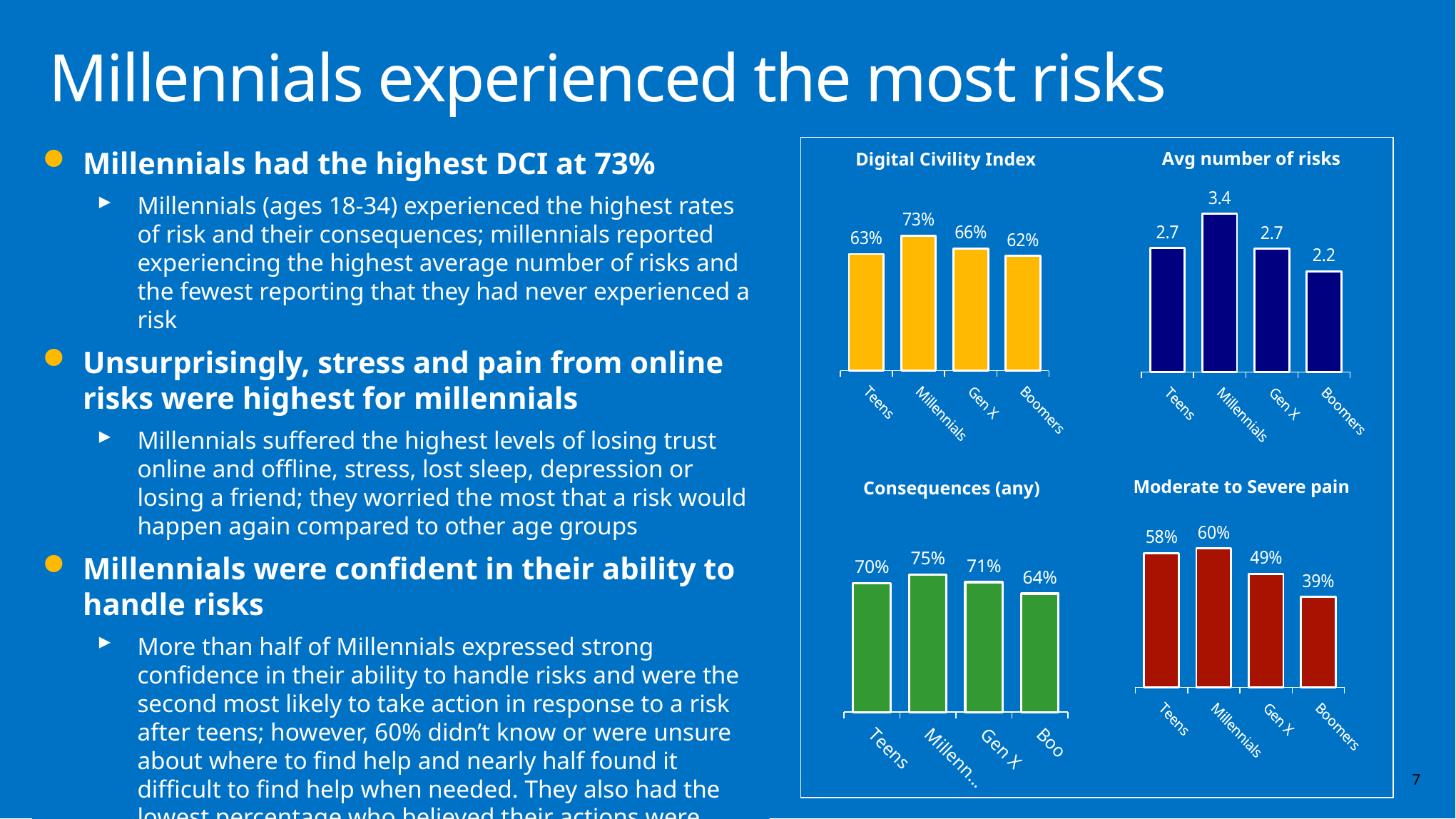
In the Consequences (any) chart, what is the value for Teens? 70% In the Consequences (any) chart, which is larger, Gen X or Boomers? Gen X In the Moderate to Severe pain chart, which category has the lowest value? Boomers In the Moderate to Severe pain chart, what is the difference between Millennials and Boomers? 21% What type of chart is the Consequences (any) chart? Bar chart In the Digital Civility Index chart, what is the value for Millennials? 73% In the Avg number of risks chart, what is the difference between Millennials and Boomers? 1.2 In the Digital Civility Index chart, which category has the lowest value? Boomers How many categories are shown in the Digital Civility Index chart? 4 In the Moderate to Severe pain chart, what is the value for Gen X? 49% In the Avg number of risks chart, which category has the highest value? Millennials In the Avg number of risks chart, what is the value for Boomers? 2.2